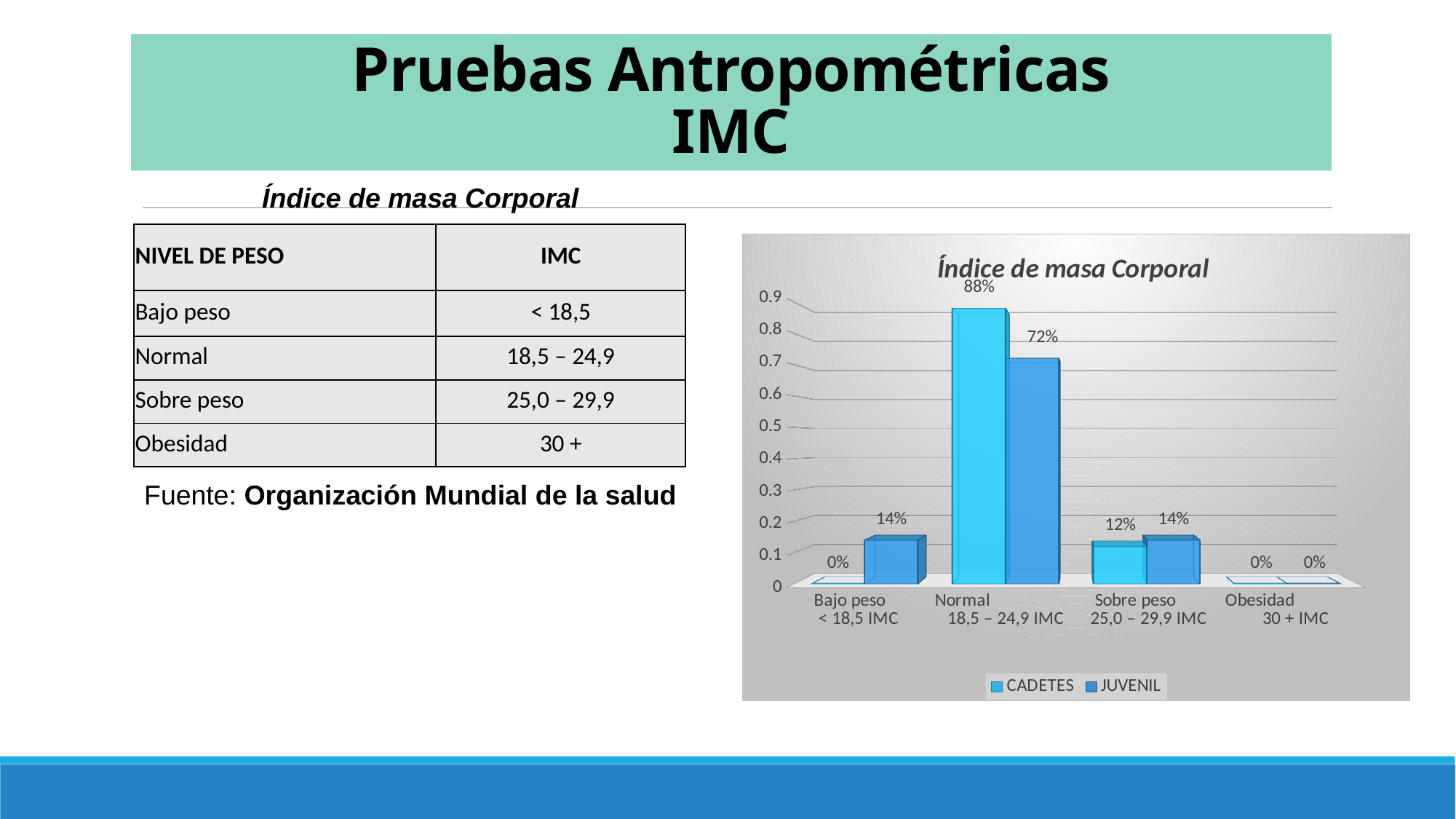
Which category has the highest CADETES value in the Índice de masa Corporal chart? Normal For Sobre peso in the Índice de masa Corporal chart, which series has the larger value, CADETES or JUVENIL? JUVENIL What is the CADETES value for Sobre peso in the Índice de masa Corporal chart? 12% What kind of chart is the Índice de masa Corporal chart? Bar chart What is the JUVENIL value for Normal in the Índice de masa Corporal chart? 72% What is the difference between the CADETES and JUVENIL values for Normal in the Índice de masa Corporal chart? 16% What are the two series named in the legend of the Índice de masa Corporal chart? CADETES and JUVENIL How many categories are shown on the x axis of the Índice de masa Corporal chart? 4 What is the CADETES value for Normal in the Índice de masa Corporal chart? 88% How many series does the legend of the Índice de masa Corporal chart list? 2 What is the JUVENIL value for Bajo peso in the Índice de masa Corporal chart? 14% What is the CADETES value for Bajo peso in the Índice de masa Corporal chart? 0%